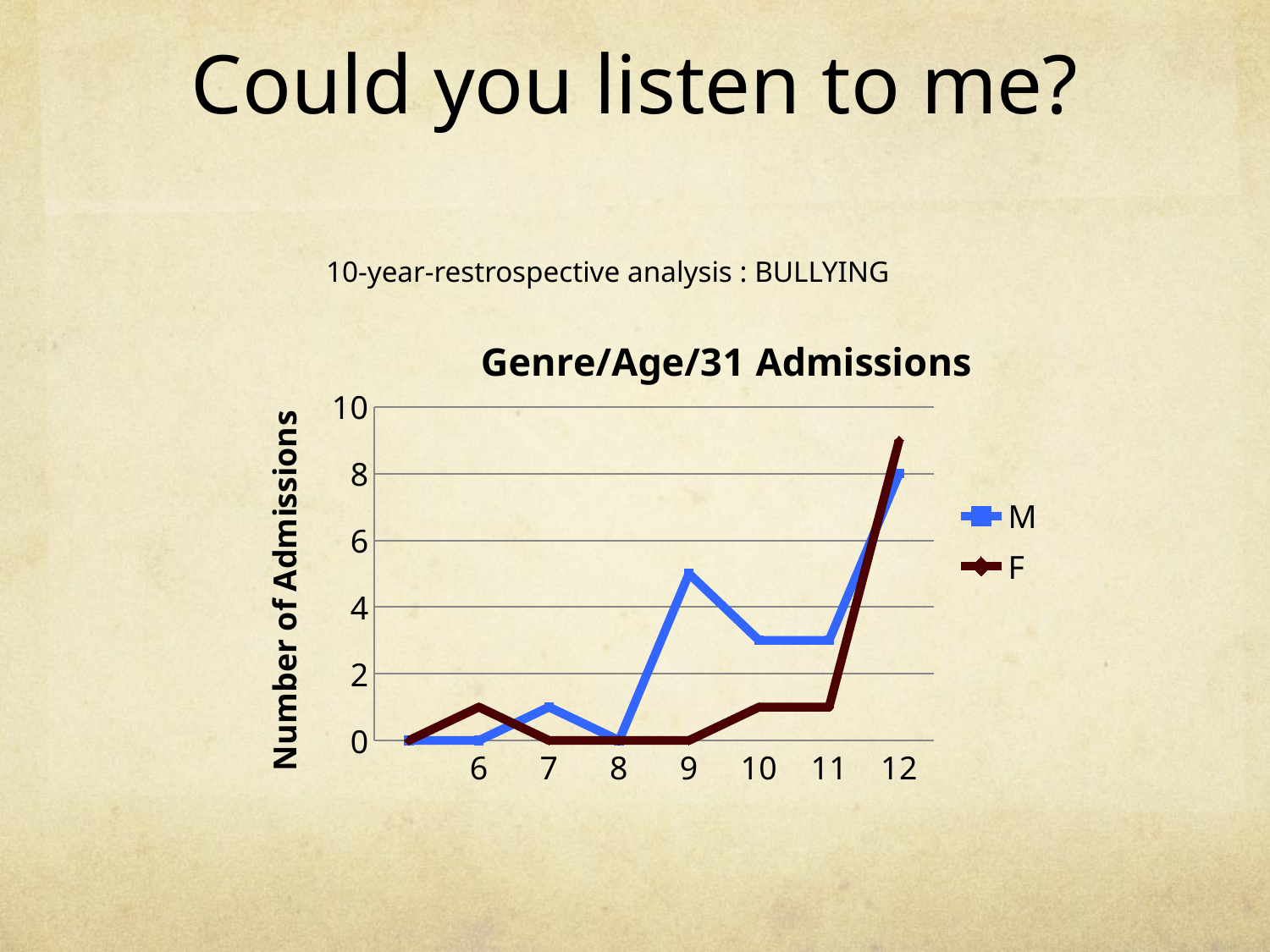
How many series does the legend list? 2 Is the value for F at age 12 greater or less than 8? greater What kind of chart is shown on the slide? line chart At age 9, which series has the larger value, M or F? M At age 12, which series has the larger value, M or F? F What is the value for F at age 8? 0 At which age does the F series reach its highest value? 12 Is the value for M at age 9 greater or less than 4? greater What is the value for M at age 12? 8 What is the title of the chart? Genre/Age/31 Admissions What are the two series named in the legend? M and F Is the value for M at age 10 greater or less than 4? less